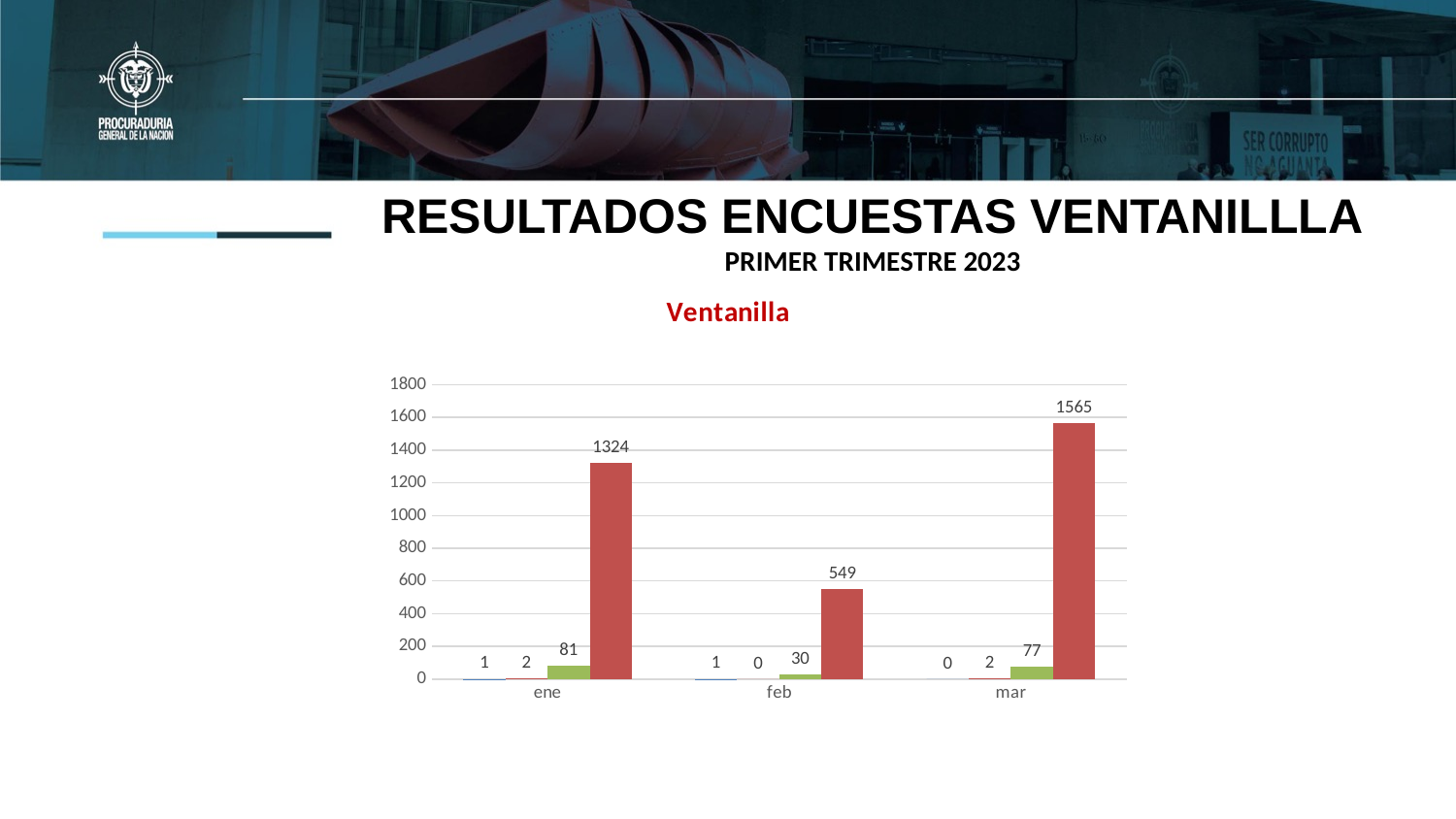
What kind of chart is shown on the slide? bar chart In which month is the red bar lowest? feb What is the value of the red bar for mar? 1565 What is the value of the red bar for feb? 549 In which month is the red bar highest? mar What is the value of the green bar for feb? 30 Which is larger, the green bar for ene or the green bar for mar? ene What is the value of the green bar for ene? 81 What is the difference between the red bar values for mar and ene? 241 How many categories are shown on the x axis of the chart? 3 What is the value of the red bar for ene? 1324 What is the title of the chart? Ventanilla